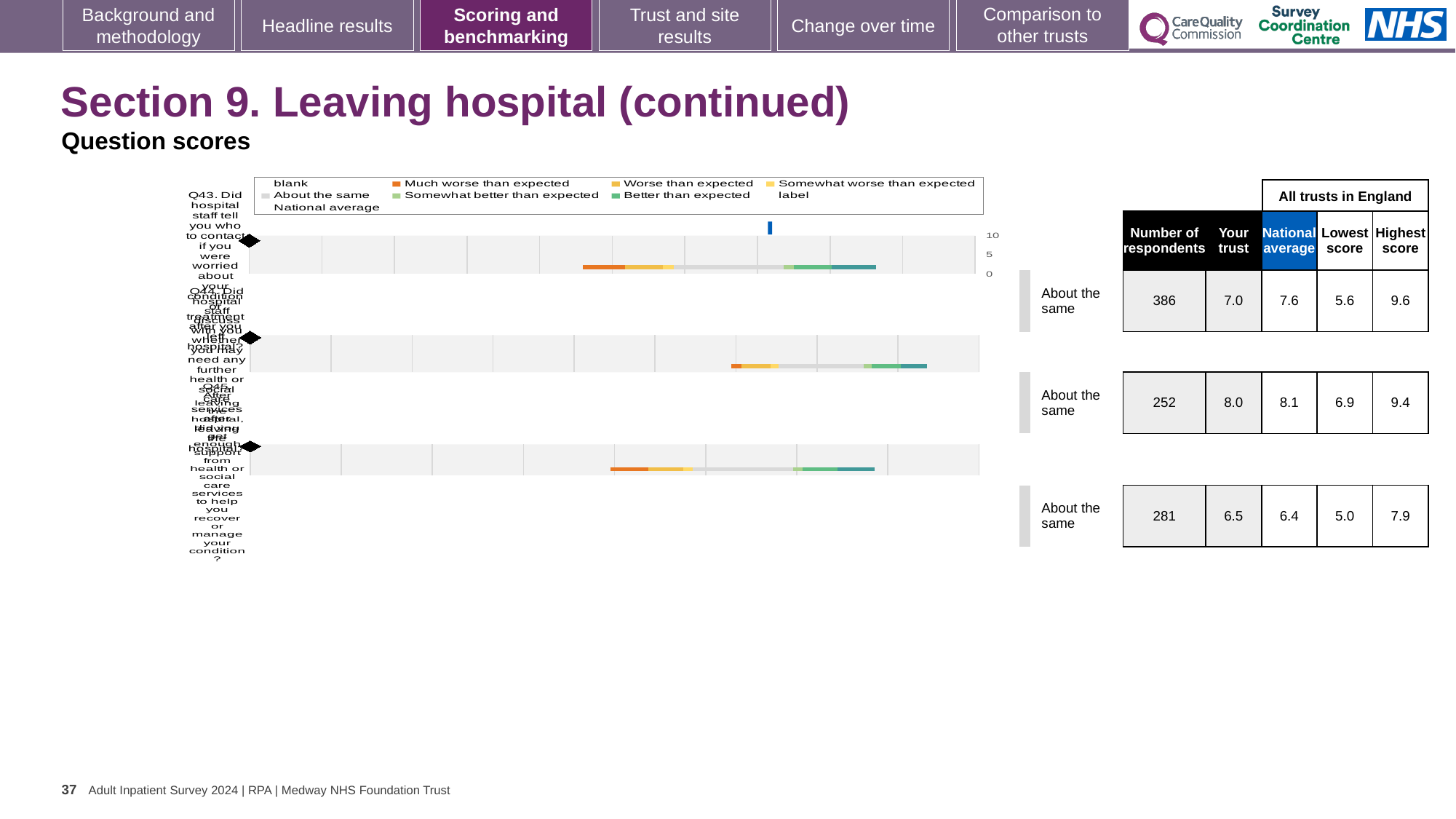
For Q45, what is the highest score among all trusts in England? 7.9 Which question has the highest 'Your trust' score? Q44 For Q44, what is the national average score? 8.1 What kind of chart is used to show the benchmarking for each question? bar chart For Q43, which is larger: the 'Your trust' score or the national average? National average For Q45, what is the lowest score among all trusts in England? 5.0 How many questions (Q43, Q44, Q45) are charted on the slide? 3 What benchmark rating is shown next to the Q45 chart? About the same Which question has the lowest number of respondents? Q44 For Q43, what is the difference between the highest score and the lowest score among all trusts in England? 4.0 For Q43, what is the number of respondents shown in the table? 386 For Q43, what is the 'Your trust' score? 7.0